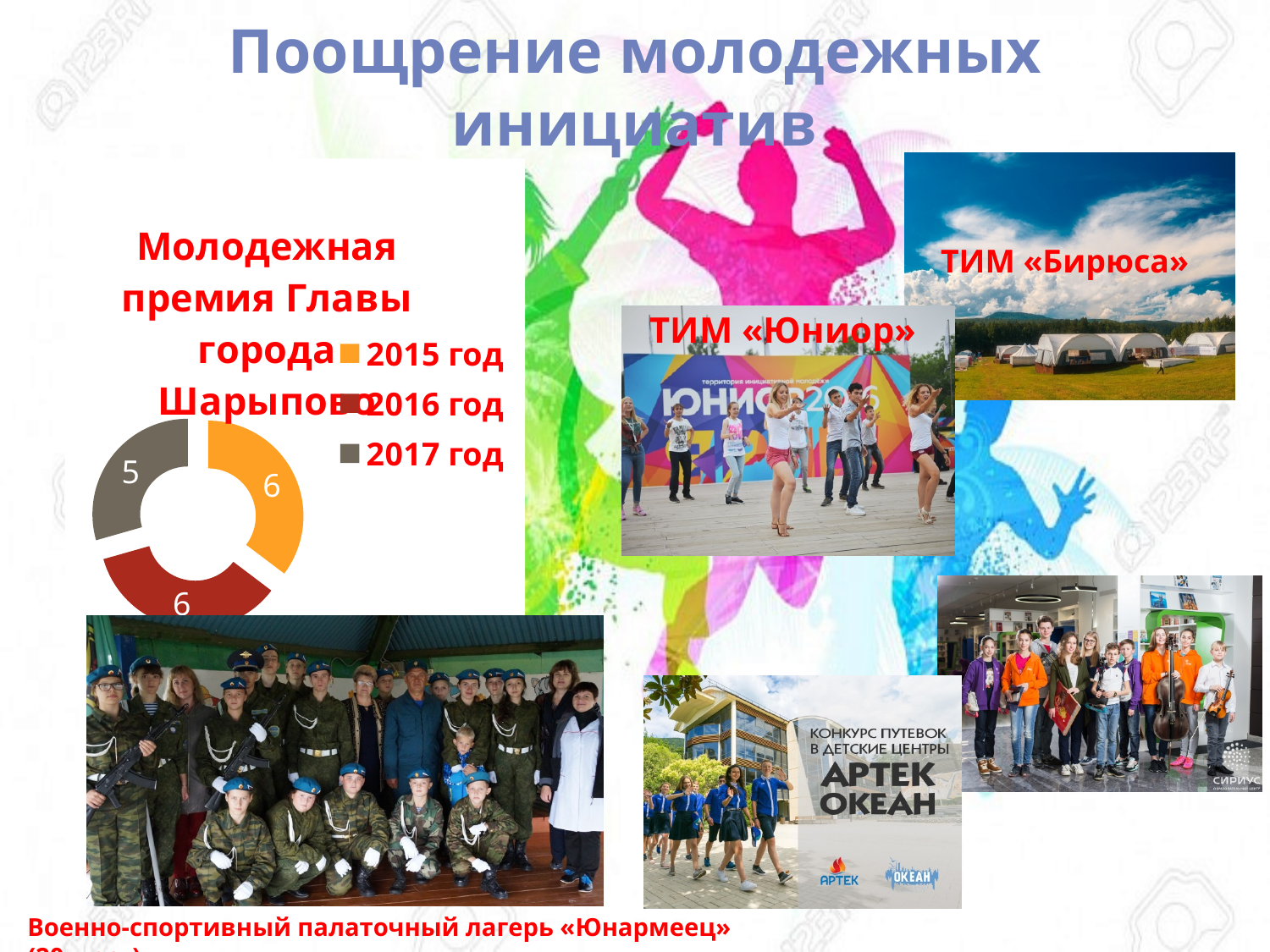
What is the total of all segments in the doughnut chart? 17 How many segments does the doughnut chart have? 3 What is the value for 2016 год in the doughnut chart? 6 Which colour represents 2015 год in the doughnut chart? orange How many entries does the legend of the doughnut chart list? 3 What is the difference between the values for 2015 год and 2017 год in the doughnut chart? 1 Which is larger in the doughnut chart, the value for 2016 год or the value for 2017 год? 2016 год Which colour represents 2017 год in the doughnut chart? gray What is the value for 2015 год in the doughnut chart? 6 What kind of chart is shown on the slide? doughnut chart Which year has the lowest value in the doughnut chart? 2017 год What is the value for 2017 год in the doughnut chart? 5